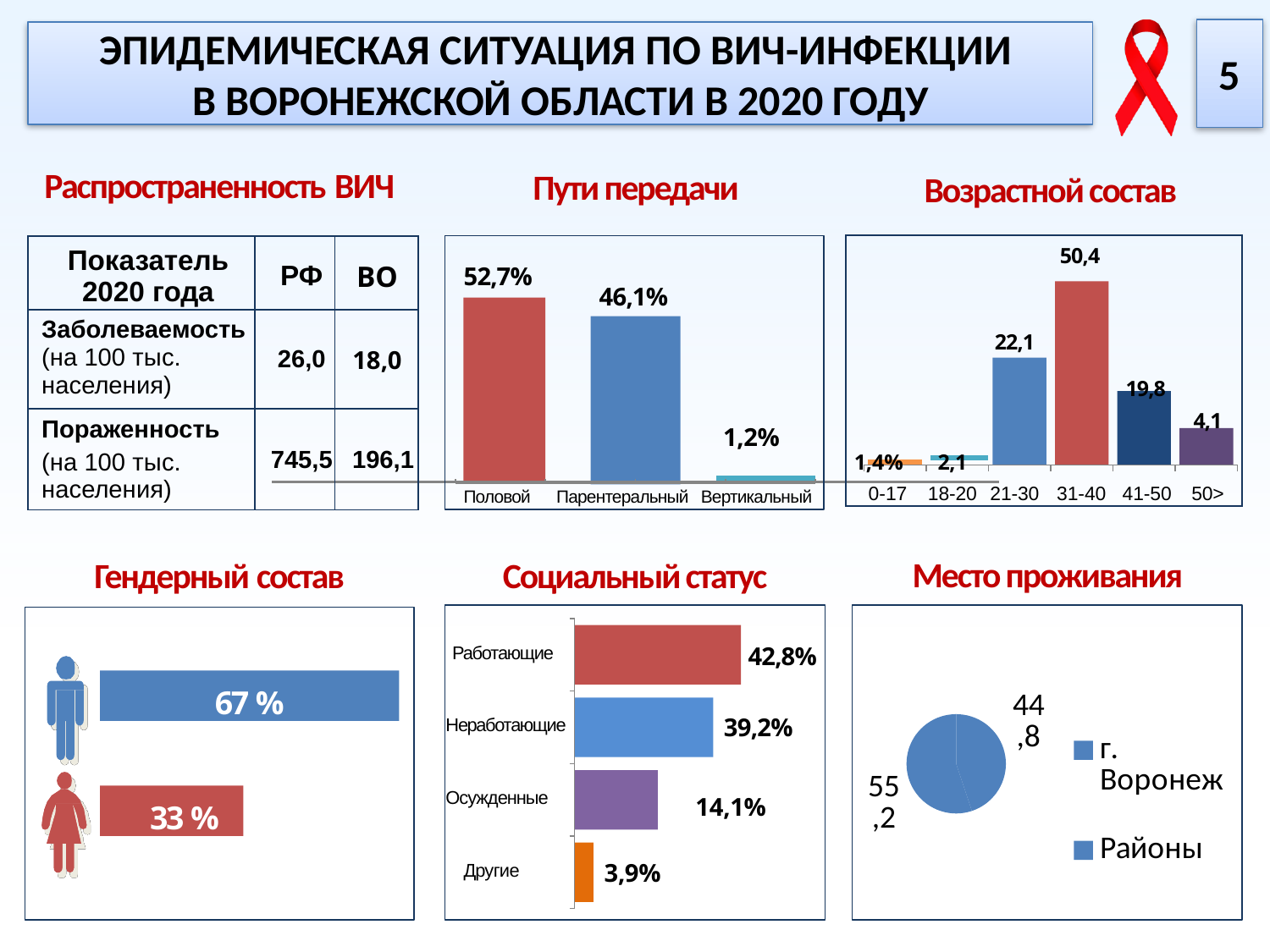
In the 'Пути передачи' chart, what is the value for Половой? 52,7% In the 'Пути передачи' chart, which category has the lowest value? Вертикальный In the 'Возрастной состав' chart, what is the value for the 21-30 age group? 22,1 In the 'Возрастной состав' chart, how many age groups are shown? 6 In the 'Возрастной состав' chart, which is larger, the value for 41-50 or the value for 50>? 41-50 In the 'Пути передачи' chart, what is the difference between Половой and Парентеральный? 6,6% How many entries does the legend of the 'Место проживания' chart list? 2 In the 'Социальный статус' chart, what is the value for Неработающие? 39,2% In the 'Возрастной состав' chart, which age group has the highest value? 31-40 In the 'Гендерный состав' chart, what is the value for the male bar? 67 % In the 'Социальный статус' chart, which category has the highest value? Работающие What kind of chart is the 'Социальный статус' chart? Bar chart